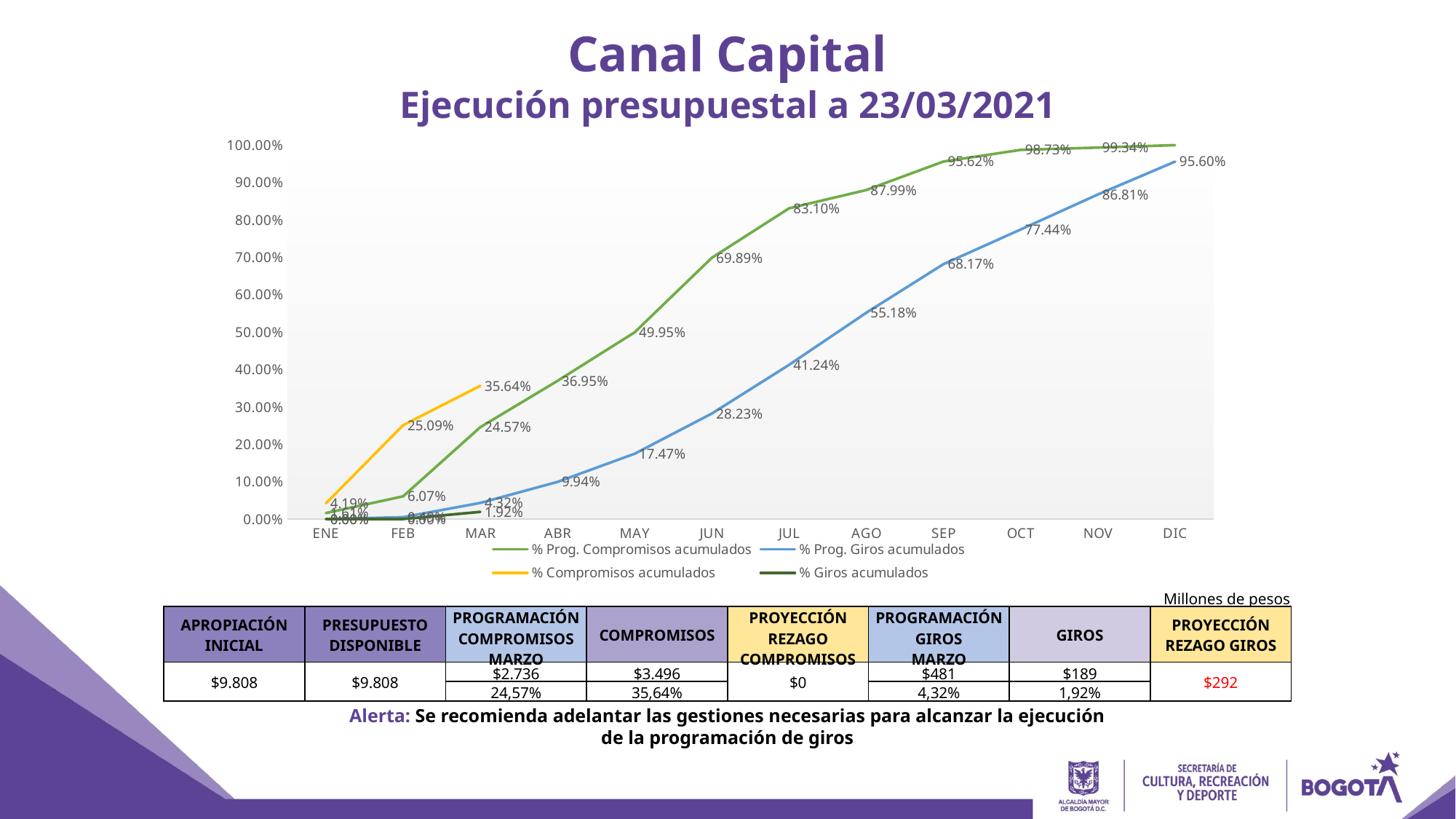
What kind of chart is shown on the slide? Line chart What is the value of % Prog. Compromisos acumulados in JUN? 69.89% What is the difference between % Compromisos acumulados and % Prog. Compromisos acumulados in MAR? 11.07% Which month has the highest value for % Prog. Giros acumulados? DIC How many months are shown on the x axis of the chart? 12 How many series does the chart legend list? 4 What is the value of % Prog. Giros acumulados in DIC? 95.60% Does the % Prog. Giros acumulados line rise or fall from MAR to DIC? Rises Which is larger in SEP: % Prog. Compromisos acumulados or % Prog. Giros acumulados? % Prog. Compromisos acumulados What is the value of % Compromisos acumulados in MAR? 35.64% What is the value of % Compromisos acumulados in FEB? 25.09% Is the value of % Prog. Giros acumulados in AGO greater or less than 50.00%? greater